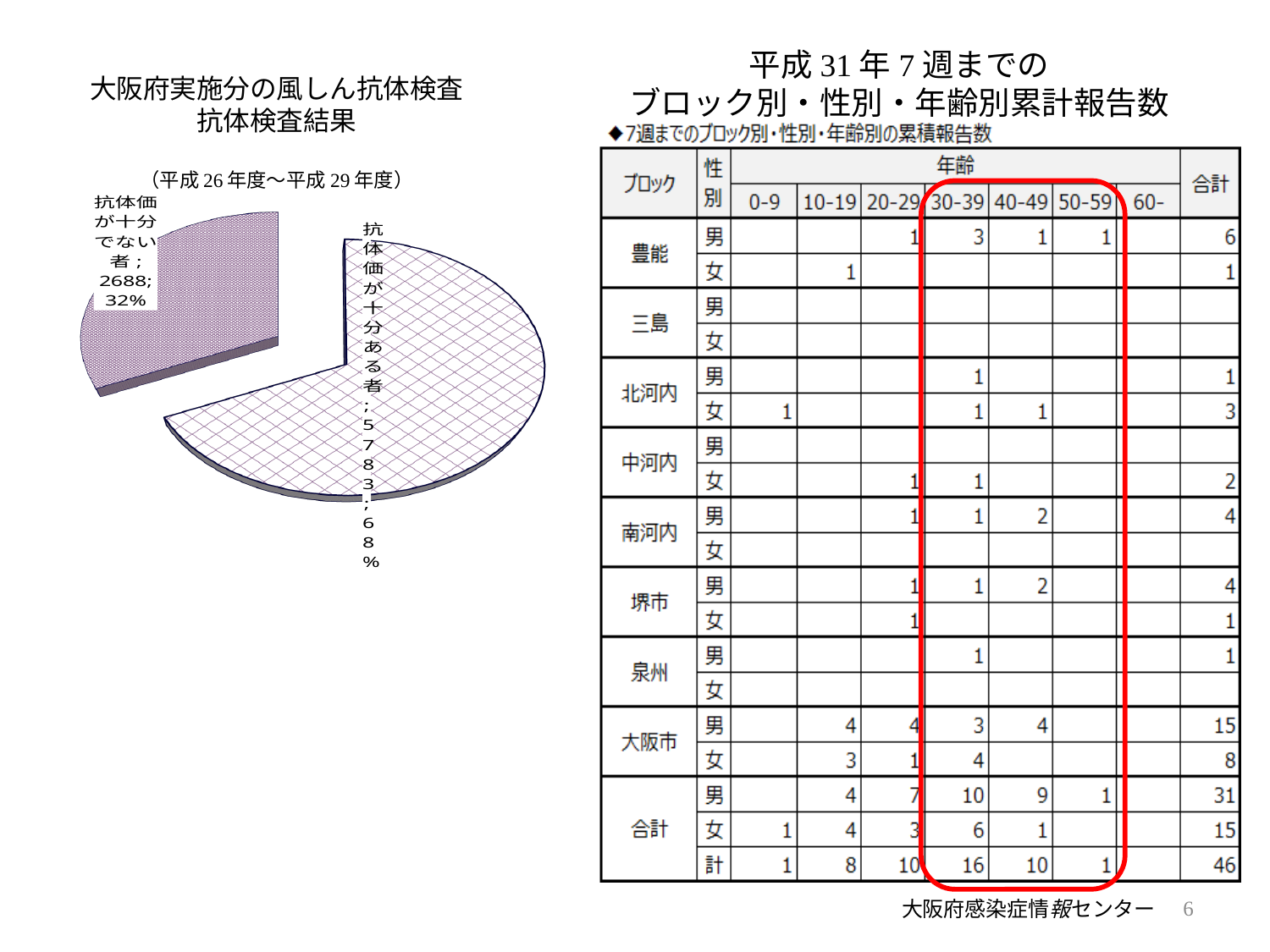
In the pie chart, what is the value for 抗体価が十分ある者? 5783 What kind of chart is shown on the left side of the slide? pie chart In the pie chart, which is larger: 抗体価が十分ある者 or 抗体価が十分でない者? 抗体価が十分ある者 In the pie chart, what is the difference between the values for 抗体価が十分ある者 and 抗体価が十分でない者? 3095 In the pie chart, what share of the pie does 抗体価が十分ある者 represent? 68% What period is indicated in the subtitle above the pie chart? 平成26年度～平成29年度 In the pie chart, what is the value for 抗体価が十分でない者? 2688 In the pie chart, how many slices are there? 2 In the pie chart, what is the total of the two slice values? 8471 In the pie chart, which slice is the largest? 抗体価が十分ある者 In the pie chart, which slice is the smallest? 抗体価が十分でない者 In the pie chart, what share of the pie does 抗体価が十分でない者 represent? 32%